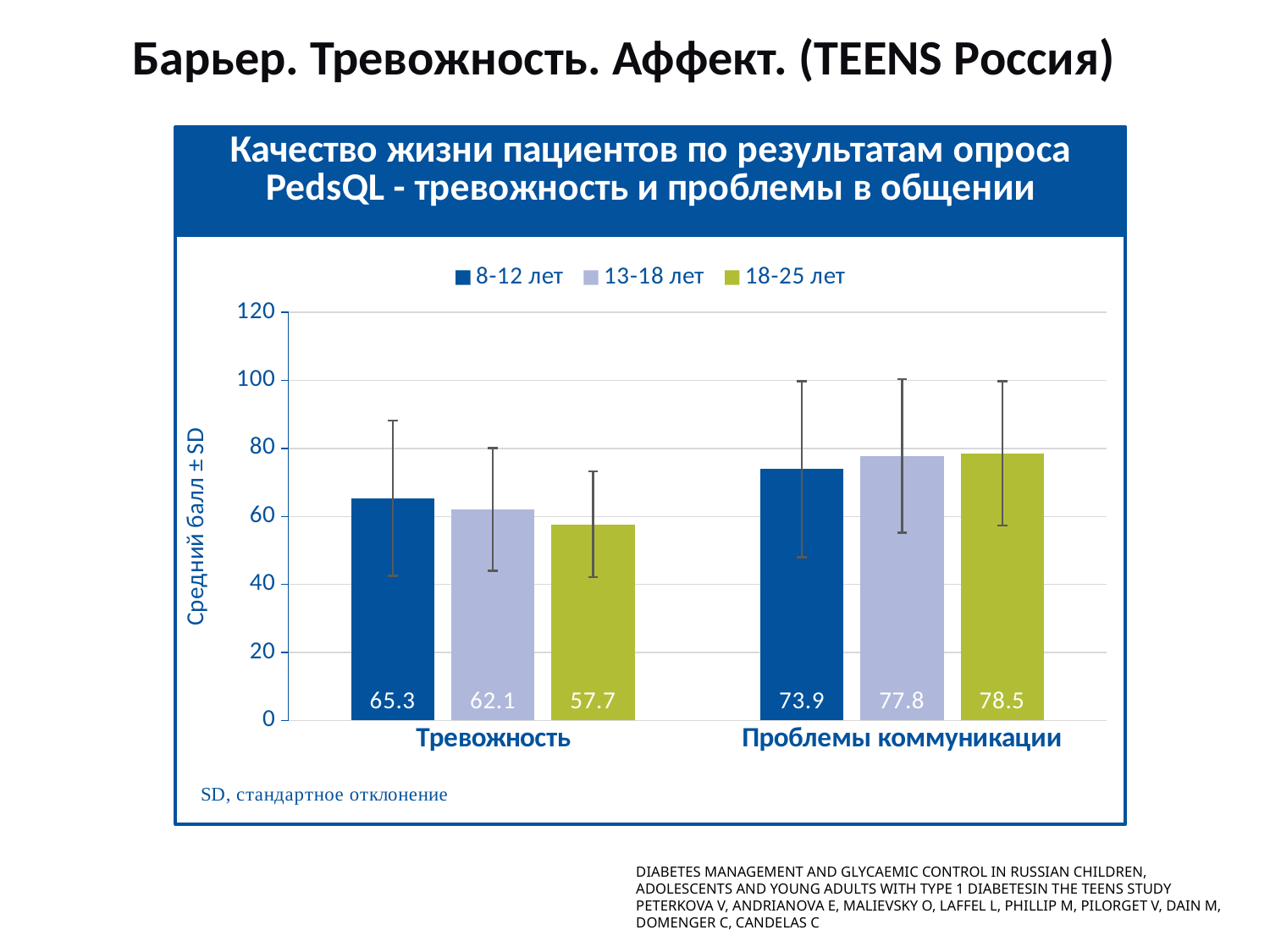
Which is larger: the 18-25 лет value for Тревожность or the 13-18 лет value for Тревожность? 13-18 лет value for Тревожность What kind of chart is shown? Bar chart What is the value for the 18-25 лет series in the Проблемы коммуникации category? 78.5 Which age group has the highest value in the Тревожность category? 8-12 лет Which age group has the lowest value in the Проблемы коммуникации category? 8-12 лет What is the value for the 13-18 лет series in the Тревожность category? 62.1 Is the value for 13-18 лет in Проблемы коммуникации greater or less than 60? greater How many categories are shown on the x axis? 2 How many series does the legend list? 3 What is the difference between the 8-12 лет values for Проблемы коммуникации and Тревожность? 8.6 What is the label of the y axis? Средний балл ± SD What is the value for the 8-12 лет series in the Тревожность category? 65.3